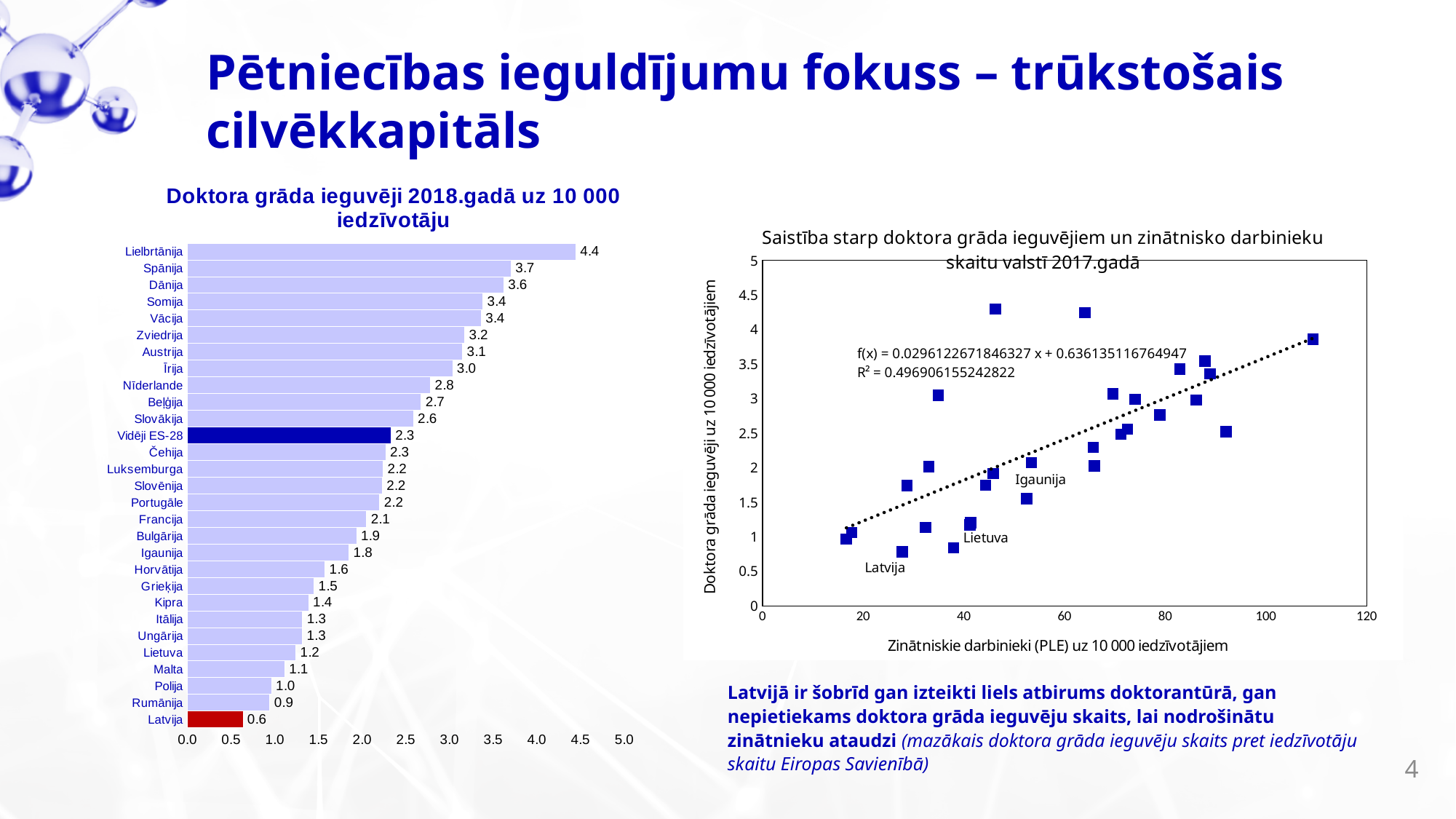
What kind of chart is the right chart 'Saistība starp doktora grāda ieguvējiem un zinātnisko darbinieku skaitu valstī 2017.gadā'? Scatter chart On the scatter chart 'Saistība starp doktora grāda ieguvējiem un zinātnisko darbinieku skaitu valstī 2017.gadā', what is the R² value shown for the trend line? 0.496906155242822 On the bar chart 'Doktora grāda ieguvēji 2018.gadā uz 10 000 iedzīvotāju', which bar is coloured red? Latvija On the bar chart 'Doktora grāda ieguvēji 2018.gadā uz 10 000 iedzīvotāju', what is the difference between the values for Lielbritānija and Latvija? 3.8 On the bar chart 'Doktora grāda ieguvēji 2018.gadā uz 10 000 iedzīvotāju', what is the value for Latvija? 0.6 On the bar chart 'Doktora grāda ieguvēji 2018.gadā uz 10 000 iedzīvotāju', which country has the highest value? Lielbrtānija On the bar chart 'Doktora grāda ieguvēji 2018.gadā uz 10 000 iedzīvotāju', what is the value for Vidēji ES-28? 2.3 On the bar chart 'Doktora grāda ieguvēji 2018.gadā uz 10 000 iedzīvotāju', how many bars are shown? 29 On the scatter chart 'Saistība starp doktora grāda ieguvējiem un zinātnisko darbinieku skaitu valstī 2017.gadā', is the vertical-axis value for Igaunija greater or less than 2.5? less On the bar chart 'Doktora grāda ieguvēji 2018.gadā uz 10 000 iedzīvotāju', which is larger, the value for Igaunija or the value for Lietuva? Igaunija What kind of chart is the left chart 'Doktora grāda ieguvēji 2018.gadā uz 10 000 iedzīvotāju'? Bar chart On the bar chart 'Doktora grāda ieguvēji 2018.gadā uz 10 000 iedzīvotāju', which country has the lowest value? Latvija